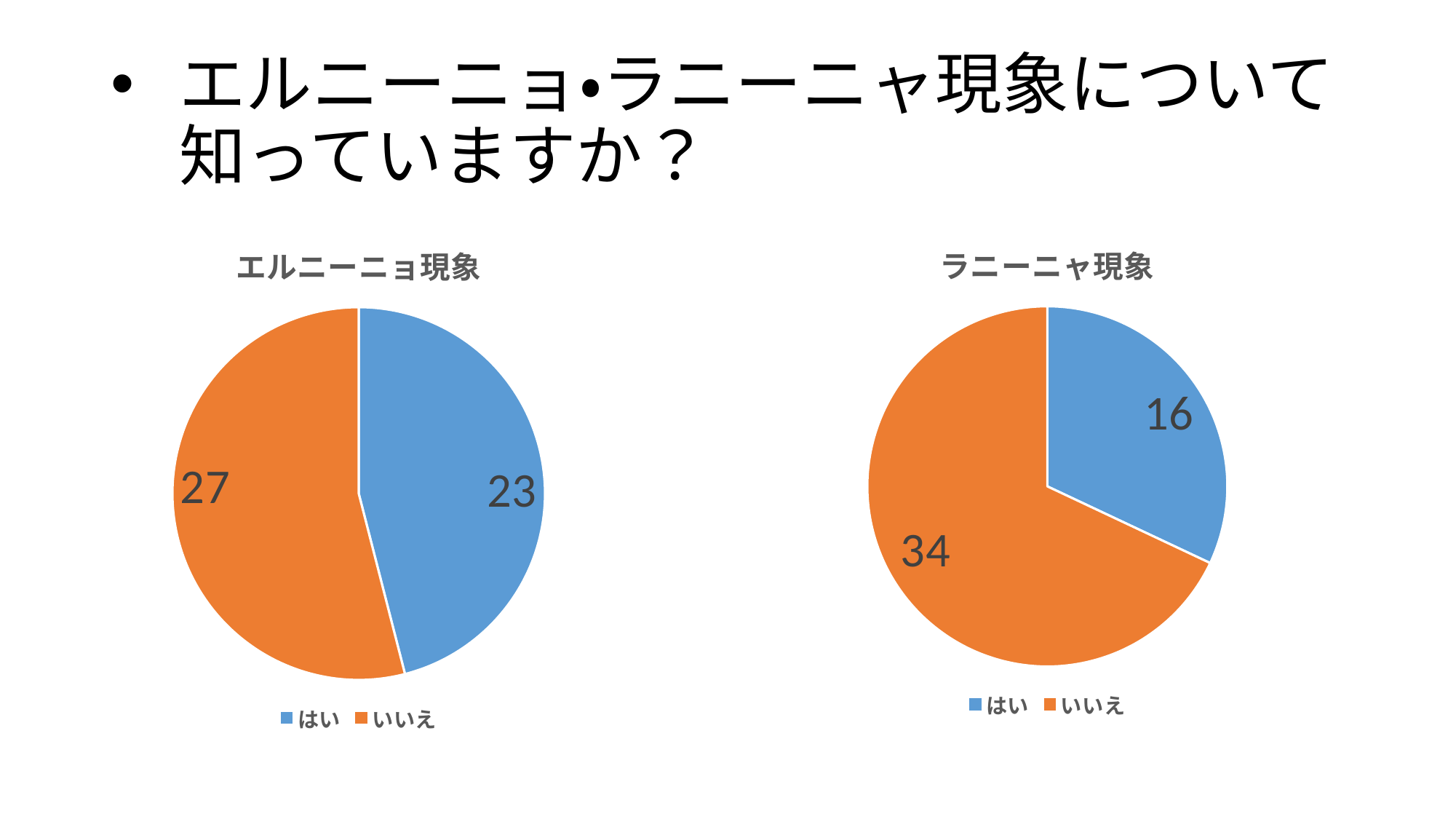
In the エルニーニョ現象 pie chart, which category has the smallest slice? はい What kind of chart is the エルニーニョ現象 chart? Pie chart In the ラニーニャ現象 pie chart, what is the difference between いいえ and はい? 18 In the ラニーニャ現象 pie chart, what share of the total does いいえ represent? 68% Which is larger: はい in the エルニーニョ現象 chart or はい in the ラニーニャ現象 chart? エルニーニョ現象 In the ラニーニャ現象 pie chart, what is the value for はい? 16 In the ラニーニャ現象 pie chart, which category has the largest slice? いいえ In the エルニーニョ現象 pie chart, what is the value for いいえ? 27 In the エルニーニョ現象 pie chart, what is the difference between いいえ and はい? 4 In the エルニーニョ現象 pie chart, what is the value for はい? 23 In the ラニーニャ現象 pie chart, what is the value for いいえ? 34 How many categories does the legend of the ラニーニャ現象 chart list? 2